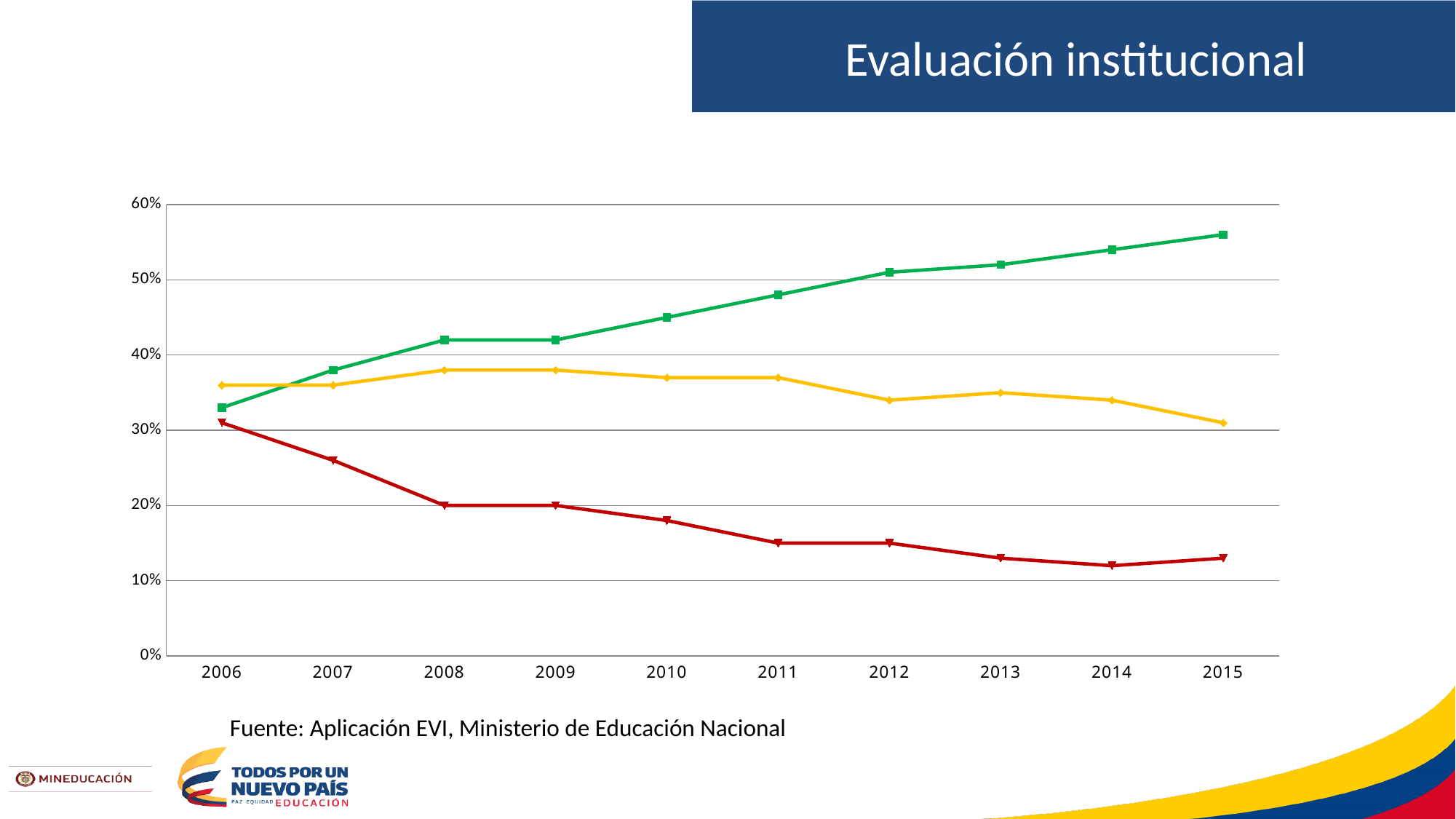
What kind of chart is shown on the slide? line chart Is the value of the yellow line in 2015 greater or less than 40%? less In 2015, which line has the higher value, the green line or the red line? green line Is the value of the green line in 2010 greater or less than 40%? greater Is the value of the green line in 2015 greater or less than 50%? greater In which year does the green line reach its highest value? 2015 What is the title shown in the header of the slide? Evaluación institucional How many years are shown along the x axis of the chart? 10 Does the green line rise or fall from 2006 to 2015? rises Does the red line rise or fall from 2006 to 2015? falls How many lines are plotted on the chart? 3